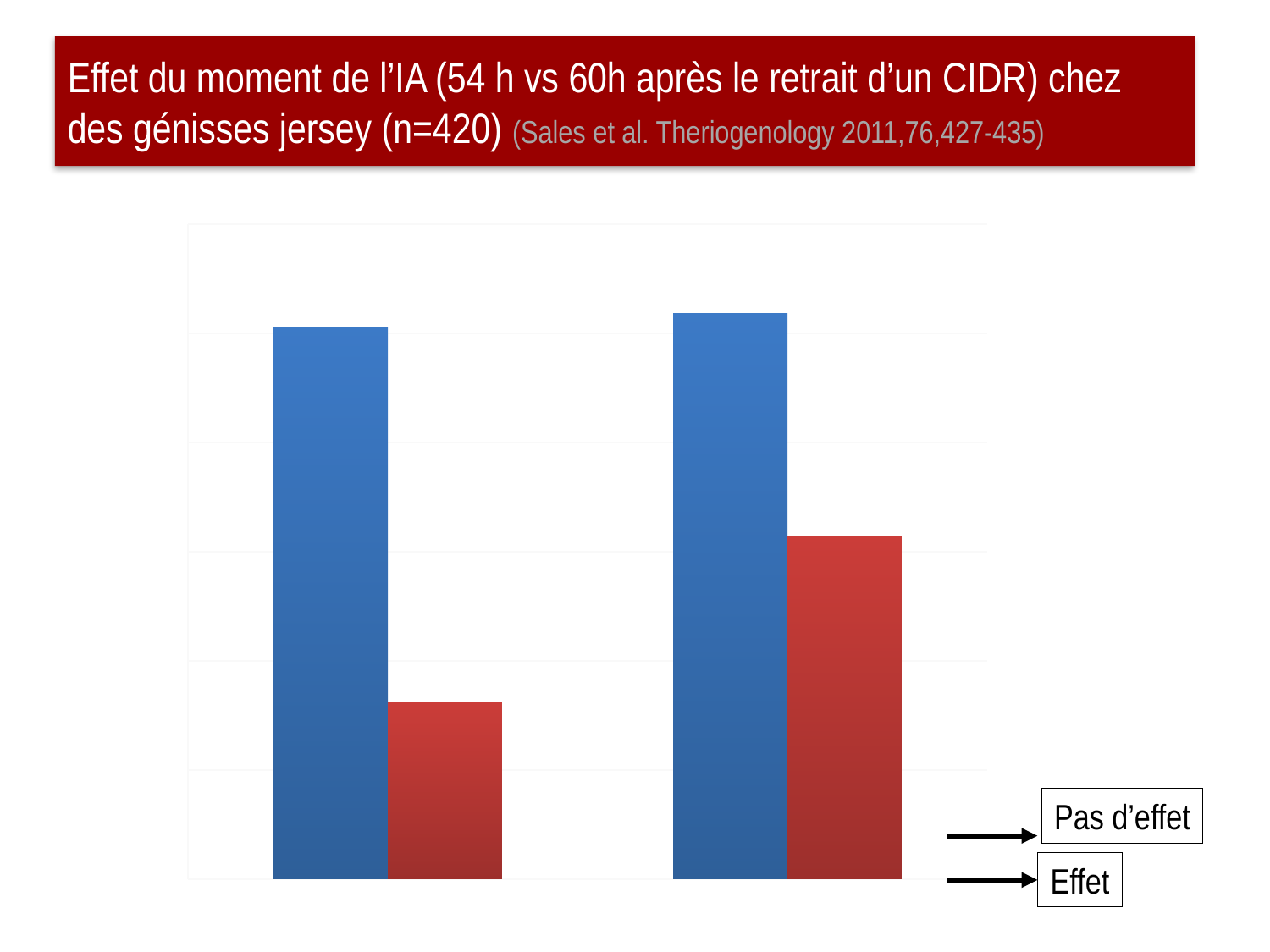
Which red bar is taller, the one in the left group or the one in the right group? the one in the right group How many bars are plotted in the chart? 4 Which bar is the shortest in the chart? the red bar in the left group How many groups of bars does the chart contain? 2 According to the slide title, how many Jersey heifers were in the study? n=420 What kind of chart is shown on the slide? bar chart What two colours are used for the bars in the chart? blue and red In the left group of bars, which is taller, the blue bar or the red bar? the blue bar Which blue bar is taller, the one in the left group or the one in the right group? the one in the right group Which bar is the tallest in the chart? the blue bar in the right group